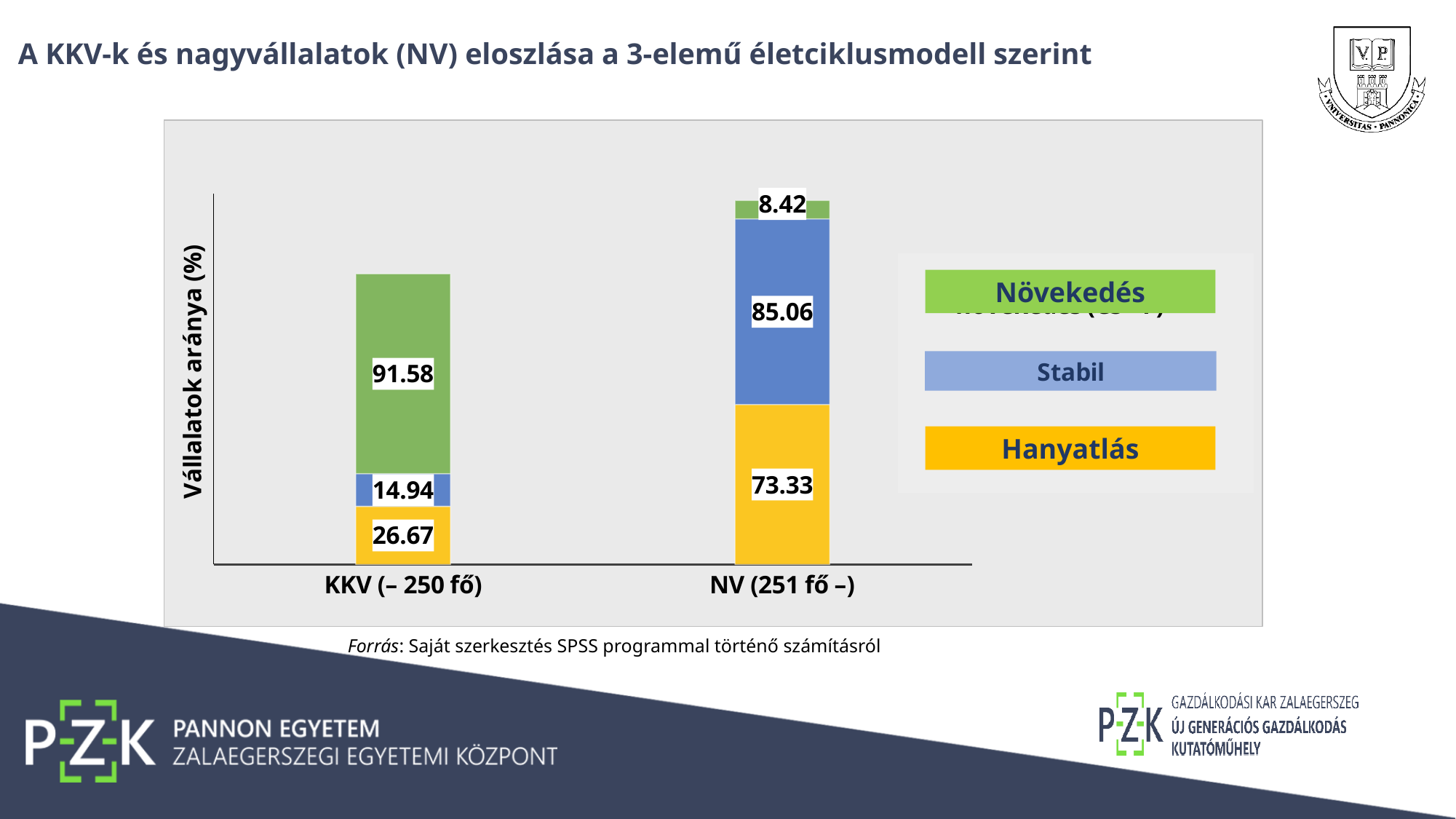
What type of chart is shown on the slide? Stacked bar chart What is the Növekedés value for NV (251 fő –)? 8.42 What is the difference between the Növekedés values for KKV (– 250 fő) and NV (251 fő –)? 83.16 What is the Stabil value for NV (251 fő –)? 85.06 What is the Hanyatlás value for KKV (– 250 fő)? 26.67 What is the Növekedés value for KKV (– 250 fő)? 91.58 How many series does the legend list? 3 Which category has the higher Stabil value, KKV (– 250 fő) or NV (251 fő –)? NV (251 fő –) How many categories are shown on the x axis? 2 What is the Hanyatlás value for NV (251 fő –)? 73.33 What is the label of the y axis? Vállalatok aránya (%) What is the difference between the Hanyatlás values for NV (251 fő –) and KKV (– 250 fő)? 46.66